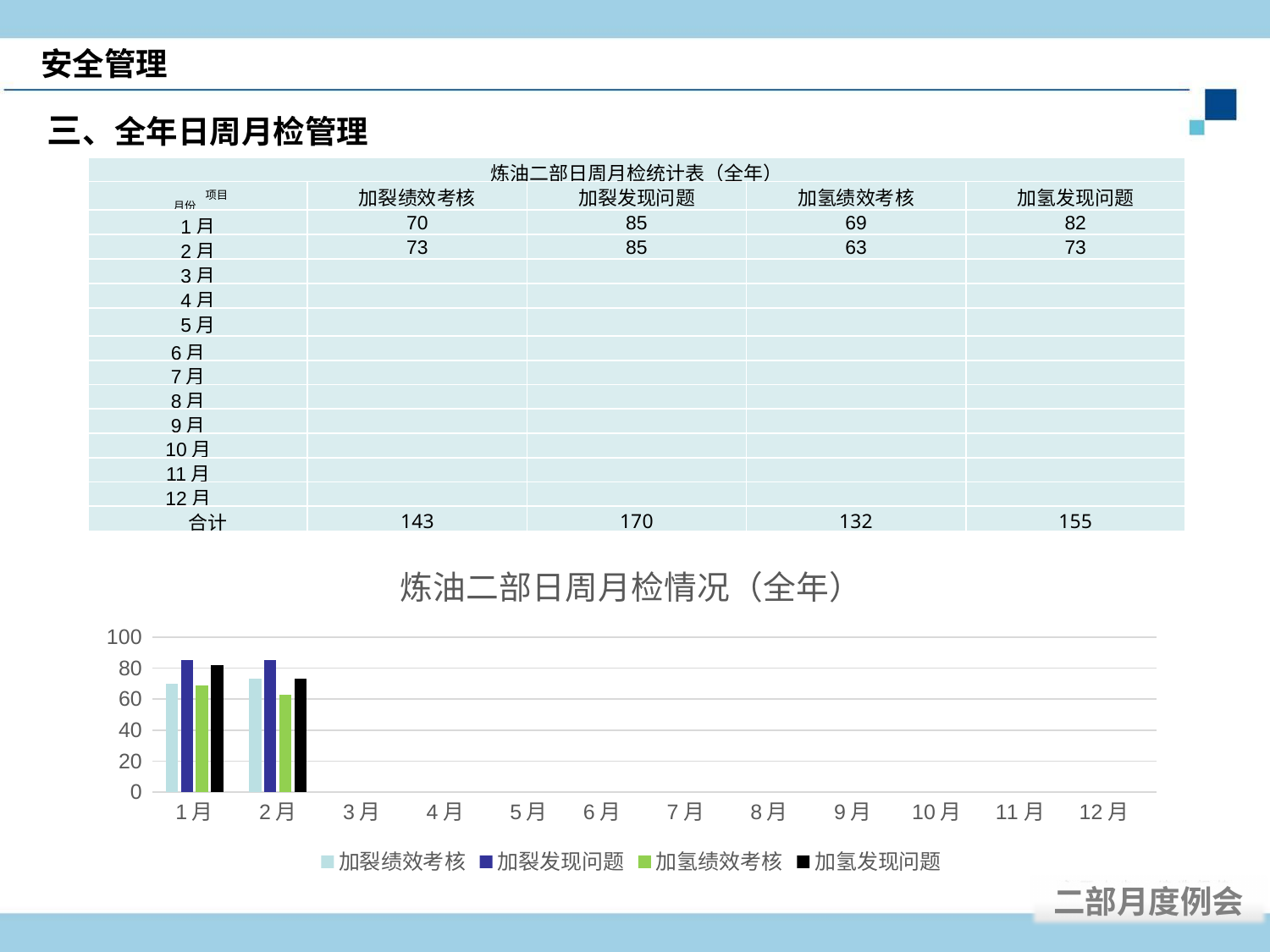
What is the difference between 加裂发现问题 and 加氢绩效考核 in 2月? 22 In the chart, which is larger in 2月: 加裂绩效考核 or 加氢绩效考核? 加裂绩效考核 In the chart, which series has the lowest bar in 2月? 加氢绩效考核 For how many months does the chart show plotted bars? 2 In the chart, is the value for 加氢绩效考核 in 2月 greater or less than 80? less What kind of chart is shown on the slide? bar chart In the chart, is the value for 加裂发现问题 in 1月 greater or less than 80? greater How many month categories are shown on the x axis of the chart? 12 What is the title of the chart? 炼油二部日周月检情况（全年） Does the value for 加氢发现问题 rise or fall from 1月 to 2月? fall What is the value of 加裂发现问题 in 2月? 85 How many series does the chart legend list? 4